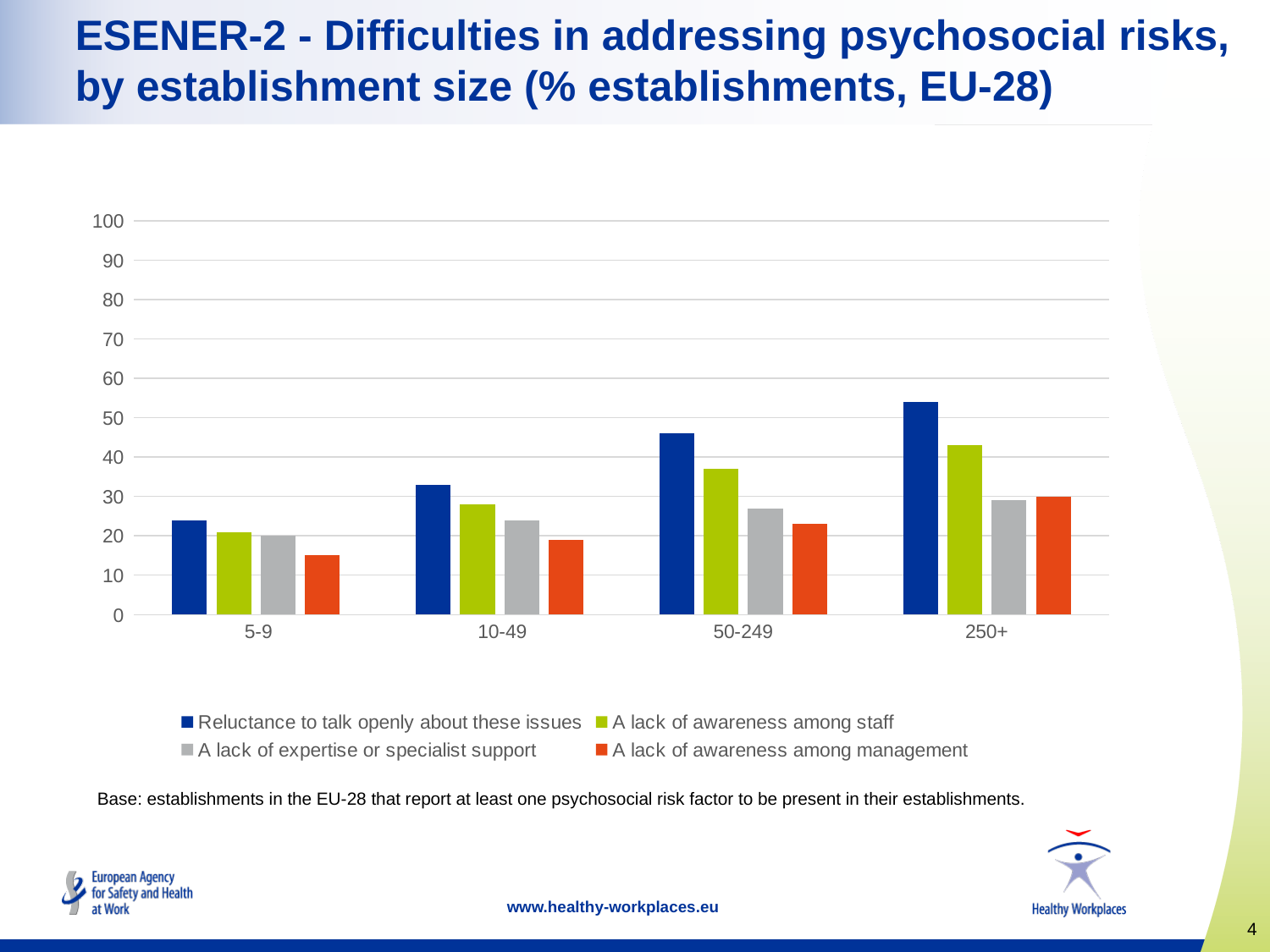
Do the values for 'Reluctance to talk openly about these issues' rise or fall as establishment size increases from 5-9 to 250+? rise Is the value for 'Reluctance to talk openly about these issues' in the 250+ category greater or less than 50? greater How many establishment size categories are shown on the x axis? 4 What colour represents 'A lack of awareness among staff' in the legend? Green Is the value for 'A lack of awareness among staff' in the 250+ category greater or less than 40? greater Which establishment size has the highest value for 'Reluctance to talk openly about these issues'? 250+ Which establishment size has the lowest value for 'A lack of awareness among management'? 5-9 Is the value for 'A lack of awareness among management' in the 5-9 category greater or less than 20? less What kind of chart is shown on the slide? Bar chart In the 50-249 category, which is larger: 'Reluctance to talk openly about these issues' or 'A lack of expertise or specialist support'? Reluctance to talk openly about these issues How many series does the legend list? 4